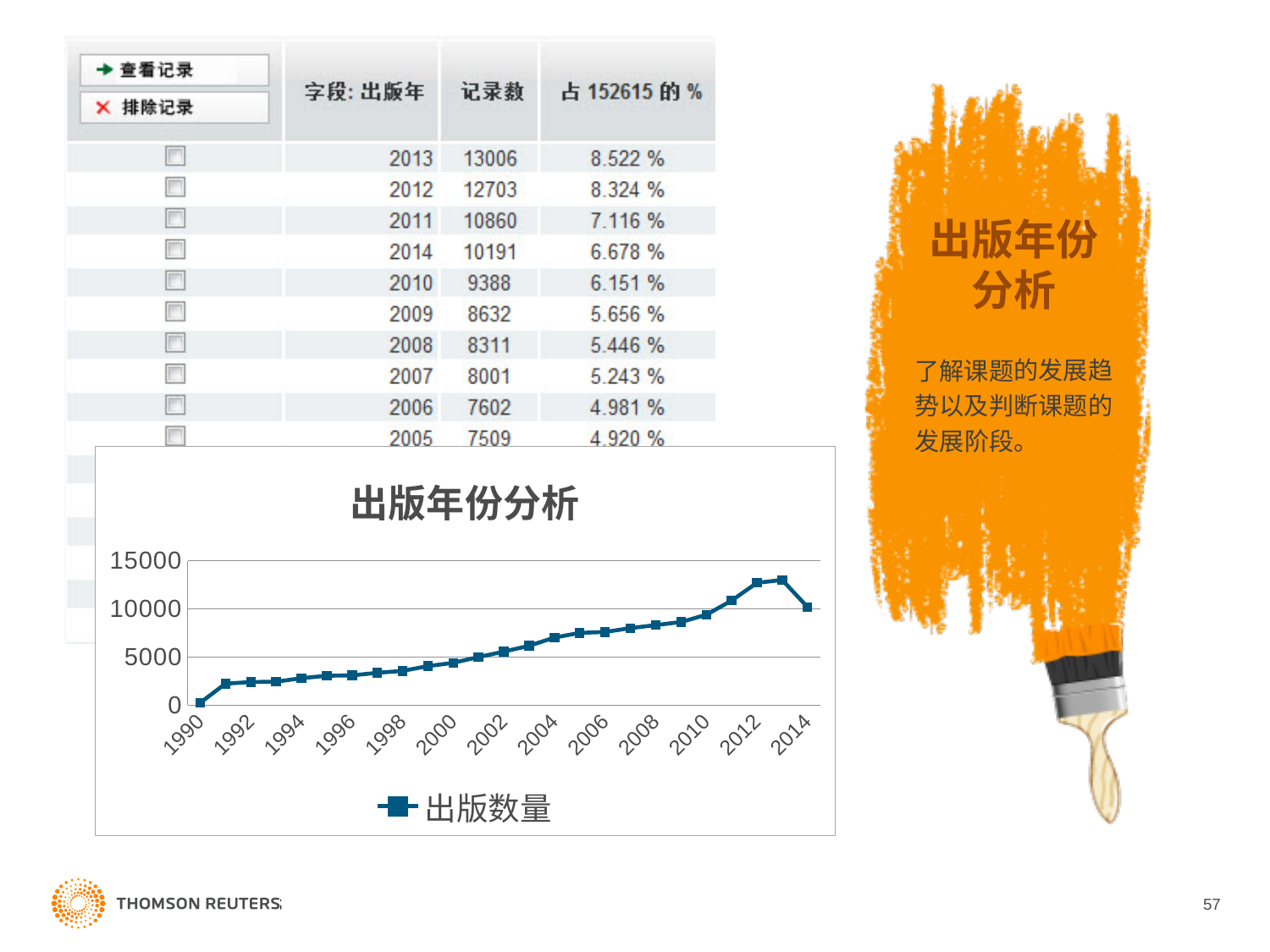
What is the title of the chart? 出版年份分析 What is the name of the series shown in the chart legend? 出版数量 Which year has the lowest value in the chart? 1990 Is the value for 1995 greater or less than 5000? less How many series does the chart legend list? 1 Do the values generally rise or fall from 1990 to 2013? rise Is the value for 2012 greater or less than 10000? greater What kind of chart is shown on the slide? line chart Is the value for 2013 greater or less than 10000? greater Which year has the highest value in the chart? 2013 Which is larger, the value for 2013 or the value for 2014? 2013